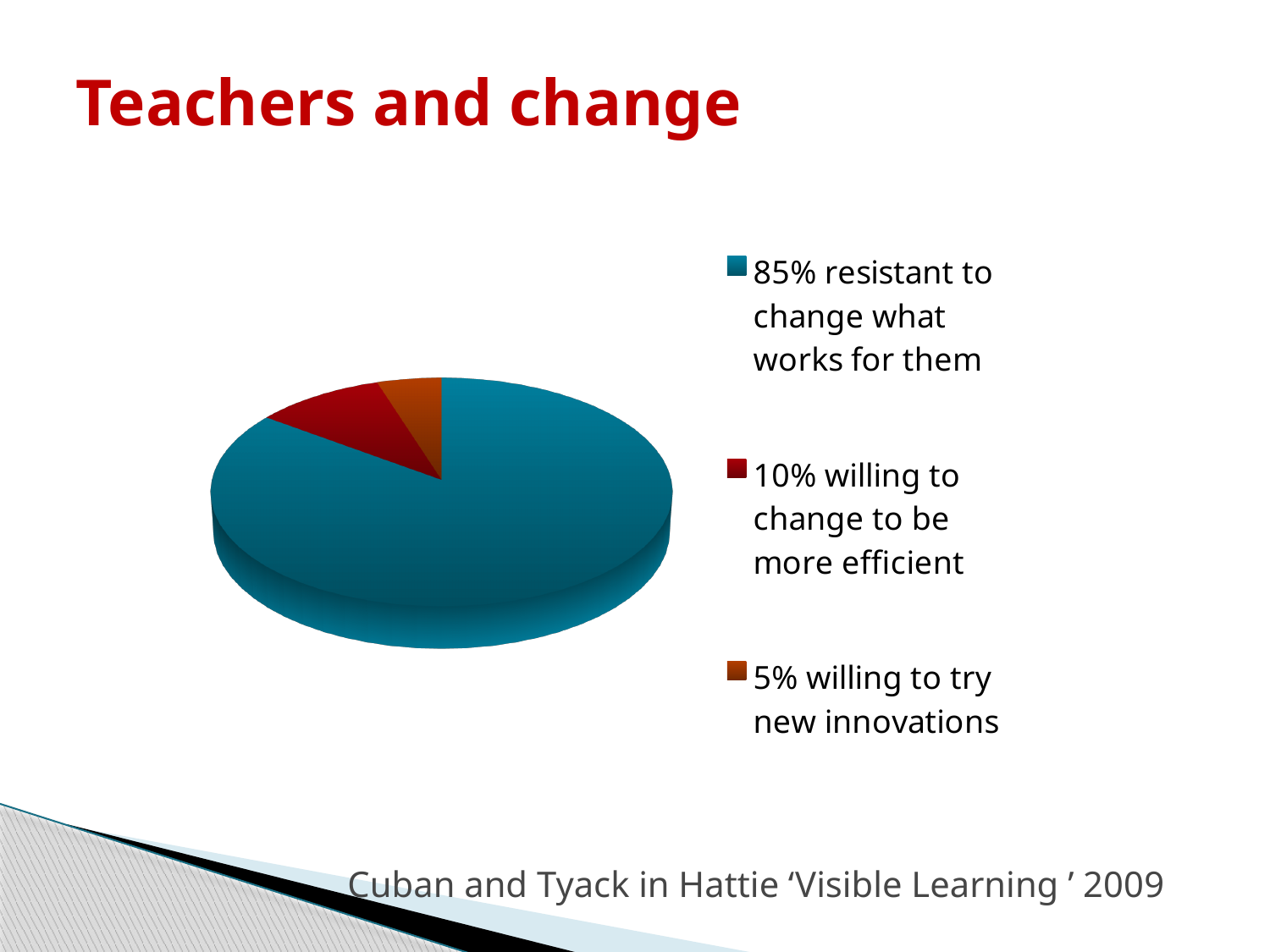
What share of teachers are willing to change to be more efficient? 10% How many entries does the legend list? 3 What share of teachers are resistant to change what works for them? 85% How many slices does the pie chart have? 3 What is the difference between the share resistant to change and the share willing to change to be more efficient? 75% Which category has the largest slice of the pie? 85% resistant to change what works for them Which is larger: the share willing to change to be more efficient or the share willing to try new innovations? willing to change to be more efficient Which category has the smallest slice of the pie? 5% willing to try new innovations What kind of chart is shown on the slide? pie chart What share of teachers are willing to try new innovations? 5% What colour is the slice for teachers resistant to change what works for them? teal blue What is the title of the slide containing the pie chart? Teachers and change